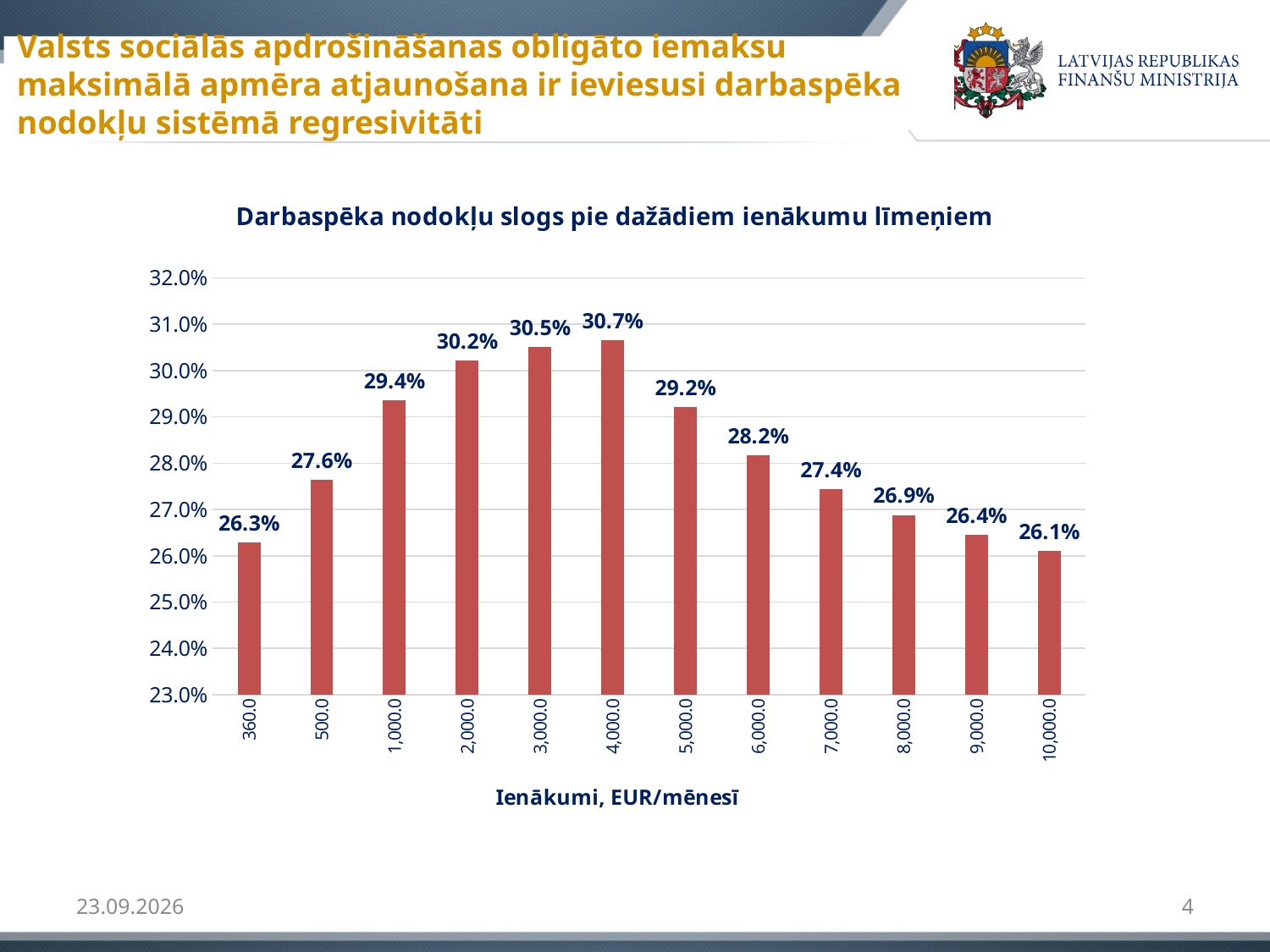
How many income levels are shown on the x axis? 12 What is the difference between the values for 4,000.0 and 10,000.0? 4.6% What kind of chart is shown on the slide? bar chart Which income level has the highest labour tax burden? 4,000.0 What is the value shown for the 7,000.0 income level? 27.4% What is the difference between the values for 2,000.0 and 500.0? 2.6% What is the value shown for the 360.0 income level? 26.3% What is the title of the chart? Darbaspēka nodokļu slogs pie dažādiem ienākumu līmeņiem What is the labour tax burden at an income of 4,000.0 EUR/month? 30.7% Is the value for 6,000.0 greater or less than 28.0%? greater Which income level has the lowest labour tax burden? 10,000.0 Which is larger, the value for 1,000.0 or the value for 5,000.0? 1,000.0